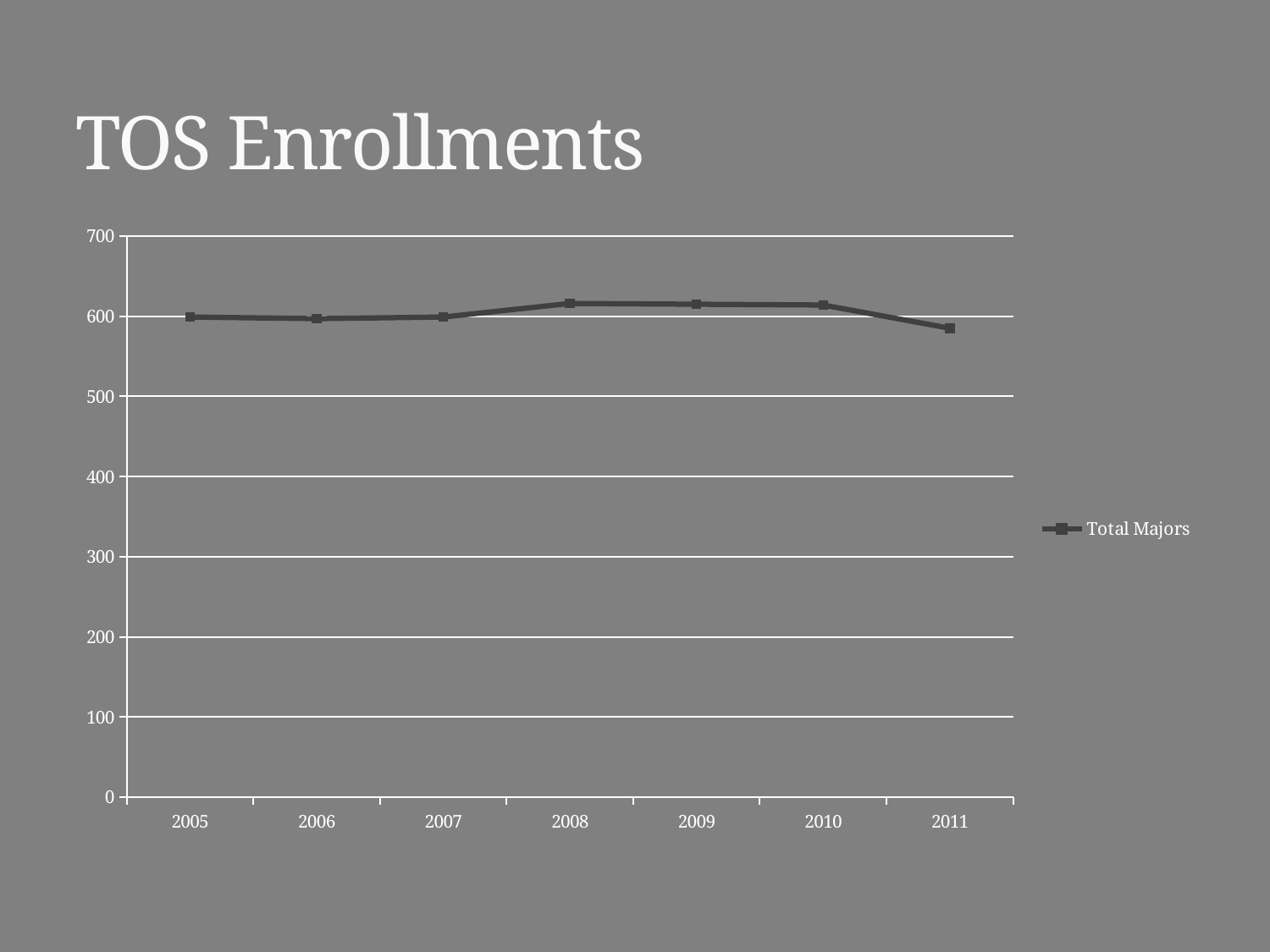
How many years are plotted along the x axis? 7 What is the title of the slide's chart? TOS Enrollments What series name does the legend list? Total Majors How many series does the legend list? 1 Which year has the larger value for Total Majors, 2006 or 2011? 2006 Does the value for Total Majors rise or fall from 2010 to 2011? fall Is the value for Total Majors in 2008 greater or less than 600? greater Which year has the larger value for Total Majors, 2008 or 2011? 2008 What kind of chart is shown on the slide? line chart Is the value for Total Majors in 2011 greater or less than 600? less Is the value for Total Majors in 2009 greater or less than 500? greater Which year has the lowest value for Total Majors? 2011